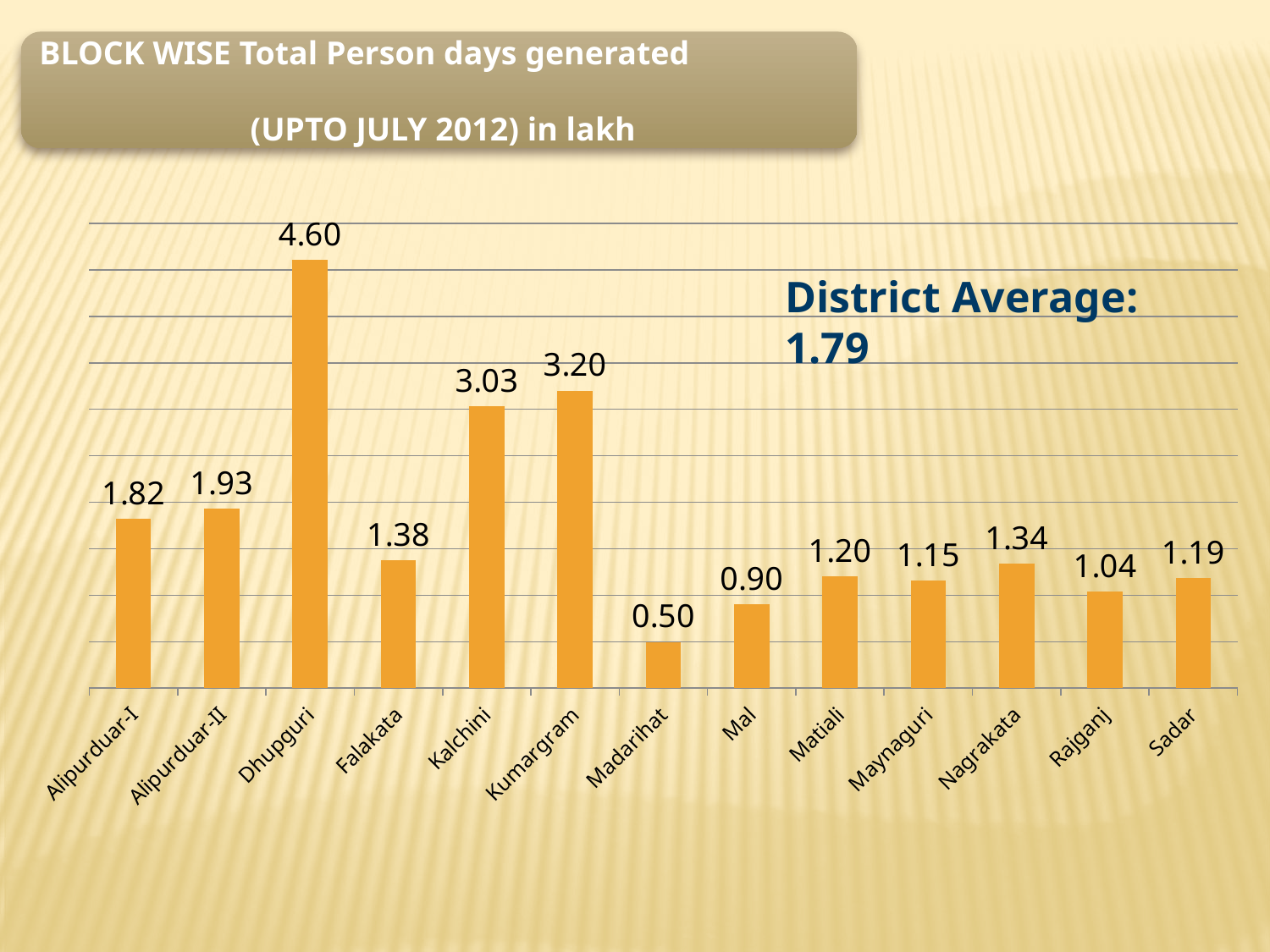
Which is larger, the value for Alipurduar-I or Alipurduar-II? Alipurduar-II Which block has the highest value? Dhupguri How many blocks are shown on the chart? 13 What is the value for Nagrakata? 1.34 What is the value for Dhupguri? 4.60 Which block has the lowest value? Madarihat What is the value for Madarihat? 0.50 What is the difference between the values for Dhupguri and Madarihat? 4.10 Which is larger, the value for Matiali or Maynaguri? Matiali What kind of chart is shown on the slide? Bar chart What is the district average stated on the slide? 1.79 What is the difference between the values for Kumargram and Kalchini? 0.17